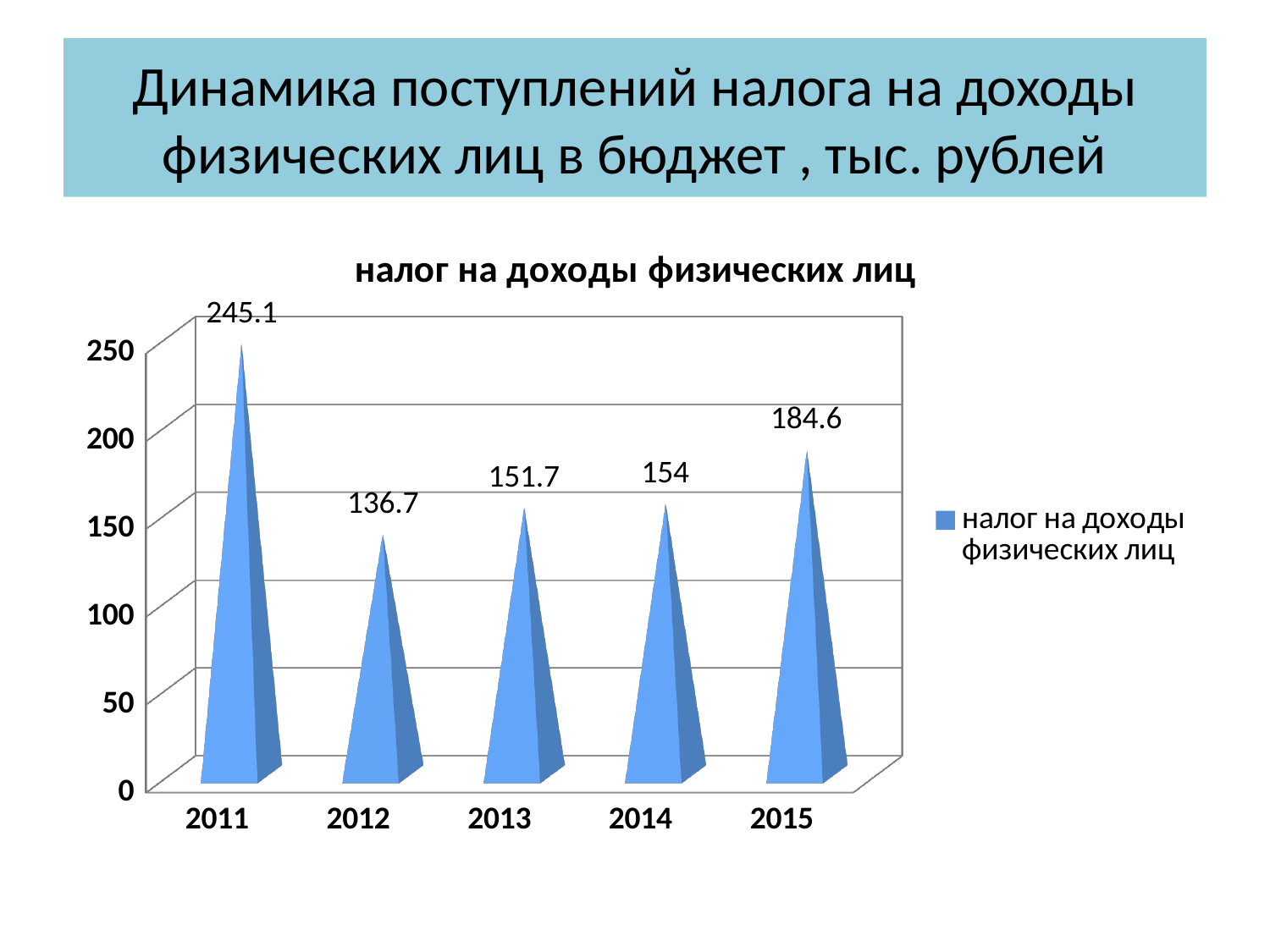
Which year has the lowest value? 2012 What is the value for 2015? 184.6 How many series does the legend list? 1 What is the difference between the values for 2015 and 2014? 30.6 Which year has the highest value? 2011 What kind of chart is shown? bar chart What is the value for 2012? 136.7 What is the difference between the values for 2011 and 2012? 108.4 Which is larger, the value for 2013 or the value for 2015? 2015 How many years are shown on the x axis? 5 What is the value for 2011? 245.1 Is the value for 2014 greater or less than 200? less